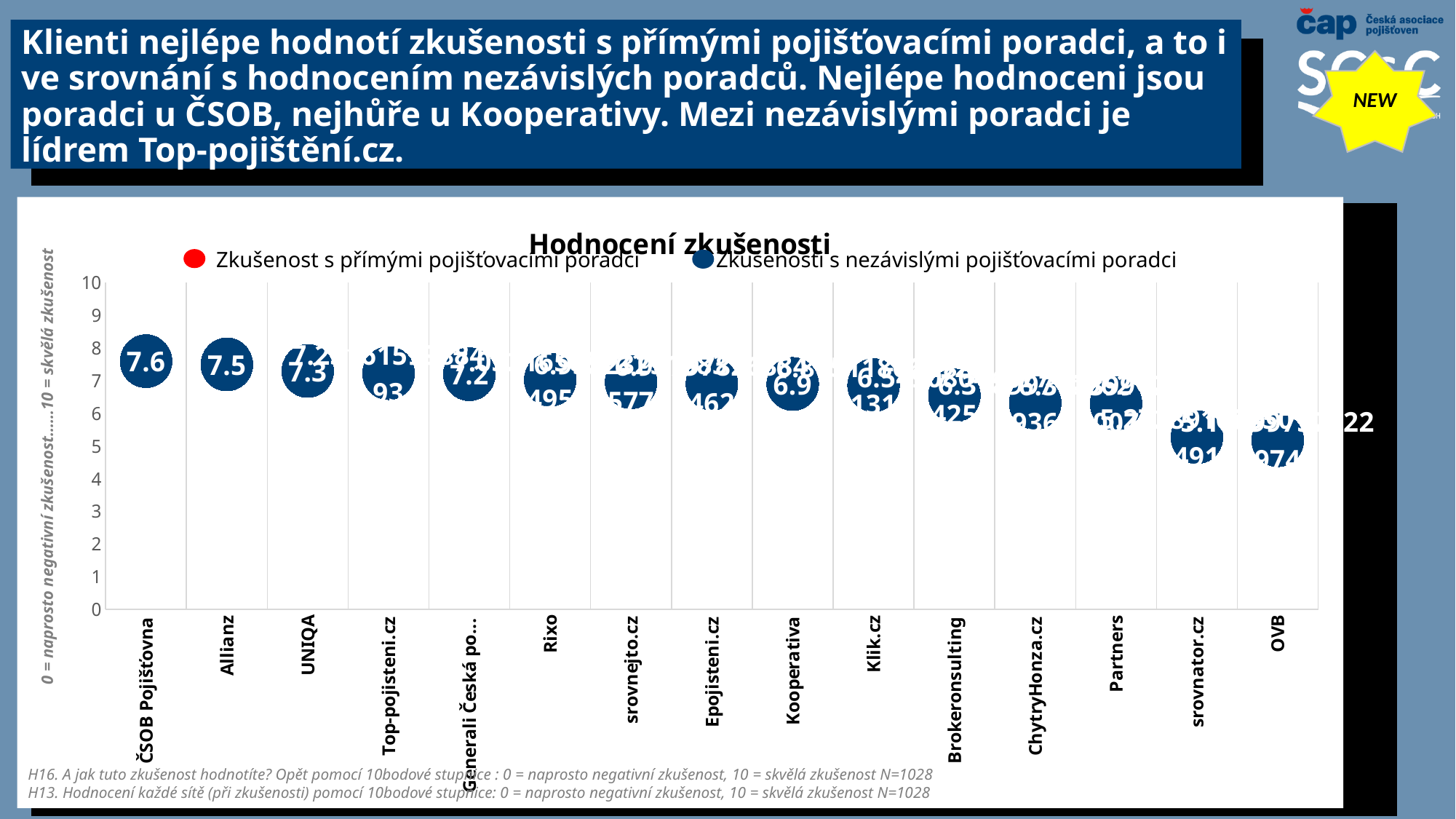
What is the value for ČSOB Pojišťovna in the Hodnocení zkušenosti chart? 7.6 How many series does the chart legend list? 2 What is the value for Kooperativa in the Hodnocení zkušenosti chart? 6.9 How many categories are shown on the x axis of the chart? 15 Which is larger, the value for Allianz or the value for Kooperativa? Allianz Is the value for OVB greater or less than 6? less What is the difference between the values for ČSOB Pojišťovna and Kooperativa? 0.7 What is the value for Allianz in the Hodnocení zkušenosti chart? 7.5 Is the value for srovnator.cz greater or less than 6? less Which category has the highest value in the Hodnocení zkušenosti chart? ČSOB Pojišťovna What is the value for UNIQA in the Hodnocení zkušenosti chart? 7.3 Do the values generally rise or fall from left to right along the x axis? fall